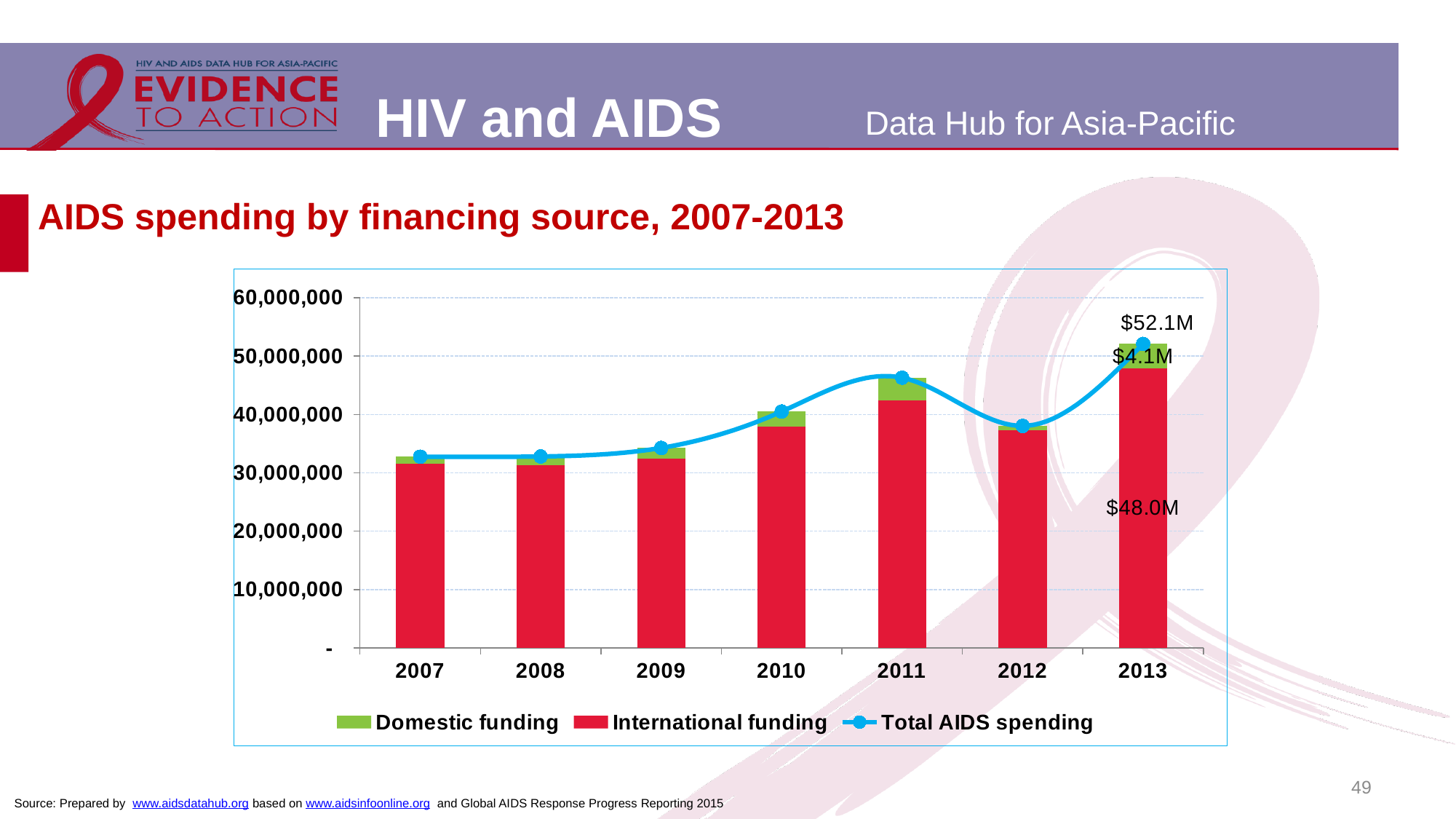
What is the domestic funding value labelled for 2013? $4.1M What is the international funding value labelled for 2013? $48.0M Is the total AIDS spending for 2011 greater or less than 40,000,000? greater Which year has higher total AIDS spending, 2011 or 2012? 2011 How many years are shown on the x axis? 7 How many series does the legend list? 3 What kind of chart is used to show domestic and international funding? bar chart What is the total AIDS spending shown for 2013? $52.1M Does total AIDS spending rise or fall from 2011 to 2012? fall In 2013, how much larger is international funding than domestic funding? $43.8M In which year is total AIDS spending highest? 2013 Is the international funding for 2012 greater or less than 40,000,000? less